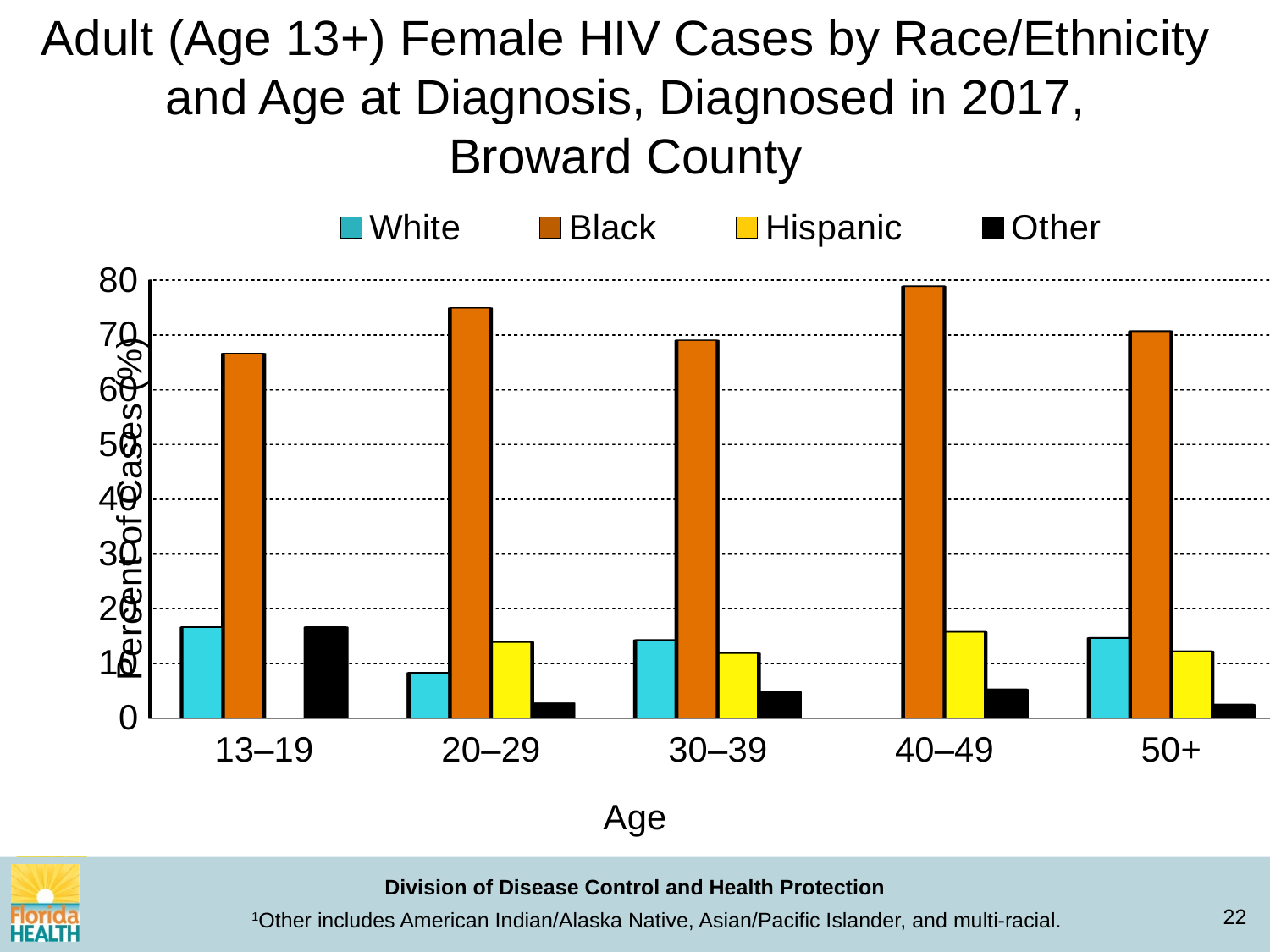
What is the title of the x axis? Age Which race/ethnicity has the highest value in every age group? Black In the 20–29 age group, which is larger, the value for White or the value for Hispanic? Hispanic Is the value for Black in the 13–19 age group greater or less than 70? less Is the value for Black in the 40–49 age group greater or less than 70? greater Is the value for Hispanic in the 40–49 age group greater or less than 20? less How many series does the legend list? 4 In the 30–39 age group, which is larger, the value for White or the value for Other? White How many age groups are shown on the x axis? 5 What kind of chart is shown on the slide? bar chart Which age group has the highest value for Black? 40–49